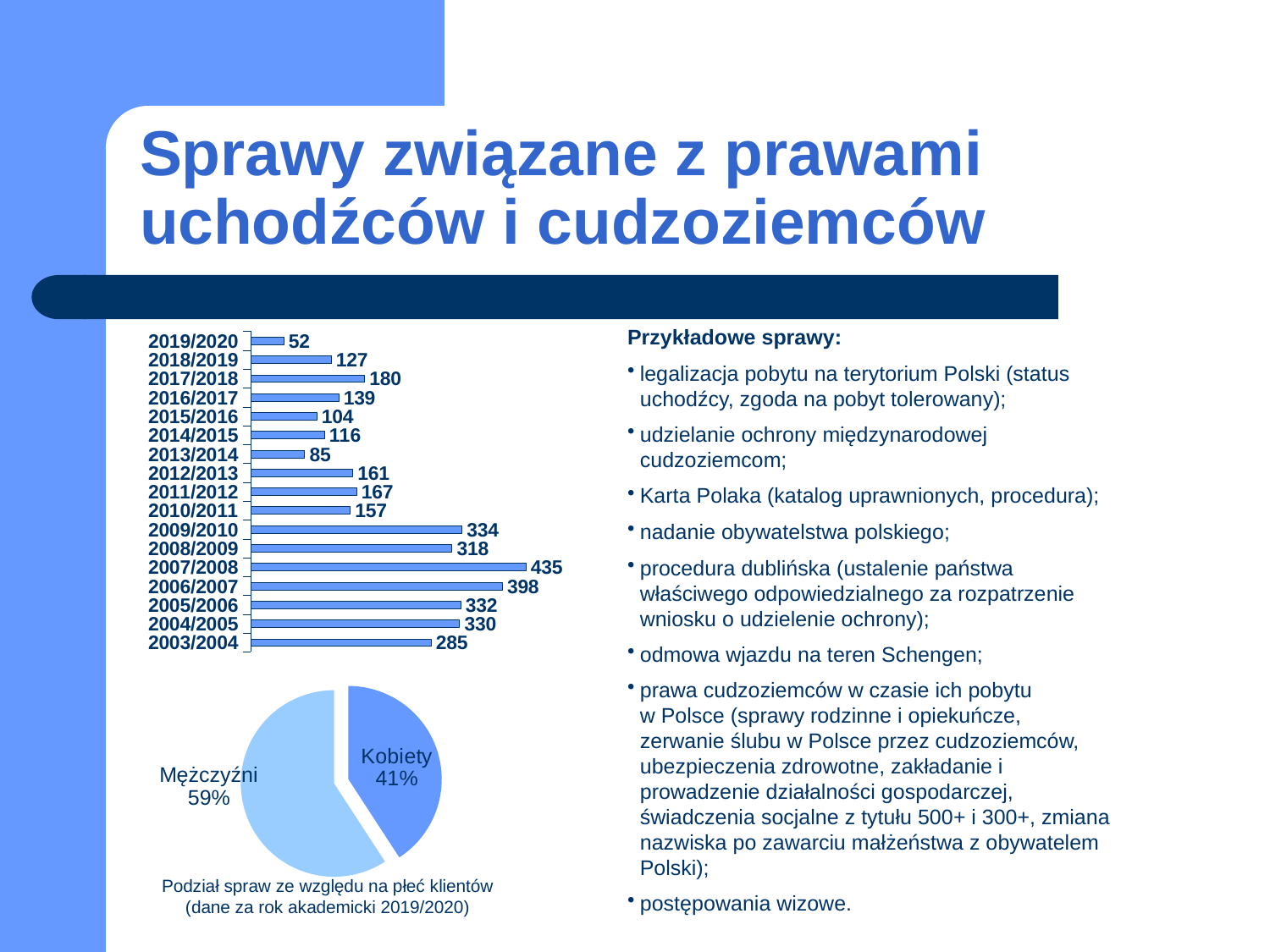
What kind of chart is the upper chart on the left of the slide? Bar chart In the pie chart titled 'Podział spraw ze względu na płeć klientów', which slice is larger, Kobiety or Mężczyźni? Mężczyźni In the bar chart on the left of the slide, which academic year has the highest value? 2007/2008 In the bar chart on the left of the slide, what is the value for 2003/2004? 285 In the bar chart on the left of the slide, what is the value for 2017/2018? 180 In the bar chart on the left of the slide, what is the difference between the values for 2007/2008 and 2006/2007? 37 In the pie chart titled 'Podział spraw ze względu na płeć klientów', what share is Kobiety? 41% In the bar chart on the left of the slide, which is larger: the value for 2012/2013 or the value for 2011/2012? 2011/2012 In the pie chart titled 'Podział spraw ze względu na płeć klientów', how many slices are there? 2 In the bar chart on the left of the slide, what is the difference between the values for 2018/2019 and 2019/2020? 75 In the bar chart on the left of the slide, how many academic years are shown? 17 In the bar chart on the left of the slide, which academic year has the lowest value? 2019/2020